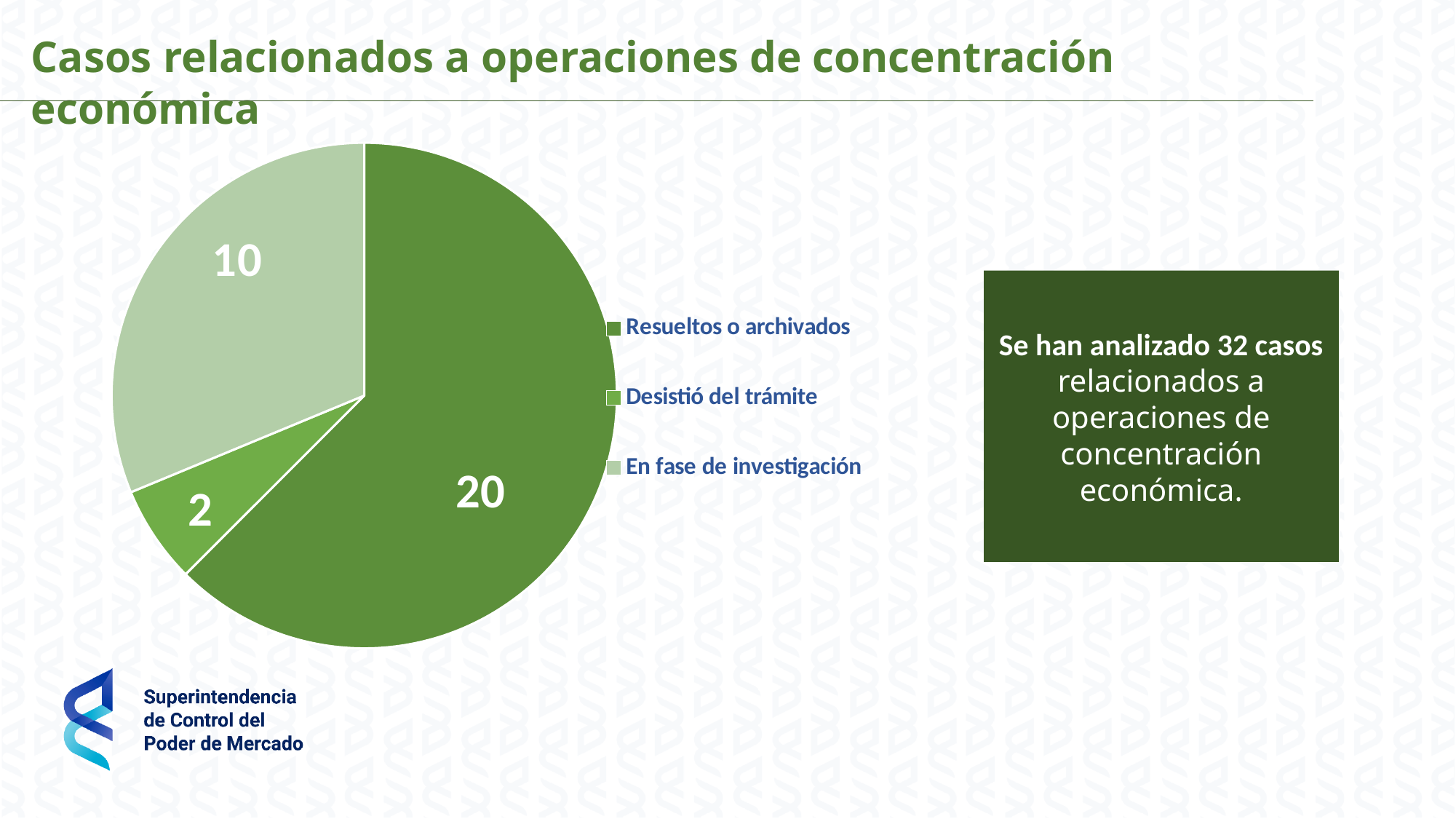
What is the total of all slices in the pie chart? 32 How many cases are labelled as 'En fase de investigación'? 10 How many categories does the pie chart show? 3 What kind of chart is shown on the slide? pie chart Which category has the smallest slice of the pie? Desistió del trámite How many cases are labelled as 'Desistió del trámite'? 2 What is the difference between the number of cases 'Resueltos o archivados' and 'En fase de investigación'? 10 What share of the pie does 'Resueltos o archivados' represent? 62.5% Which category has the largest slice of the pie? Resueltos o archivados How many cases are labelled as 'Resueltos o archivados'? 20 Which is larger: 'En fase de investigación' or 'Desistió del trámite'? En fase de investigación What is the title of the slide containing the chart? Casos relacionados a operaciones de concentración económica